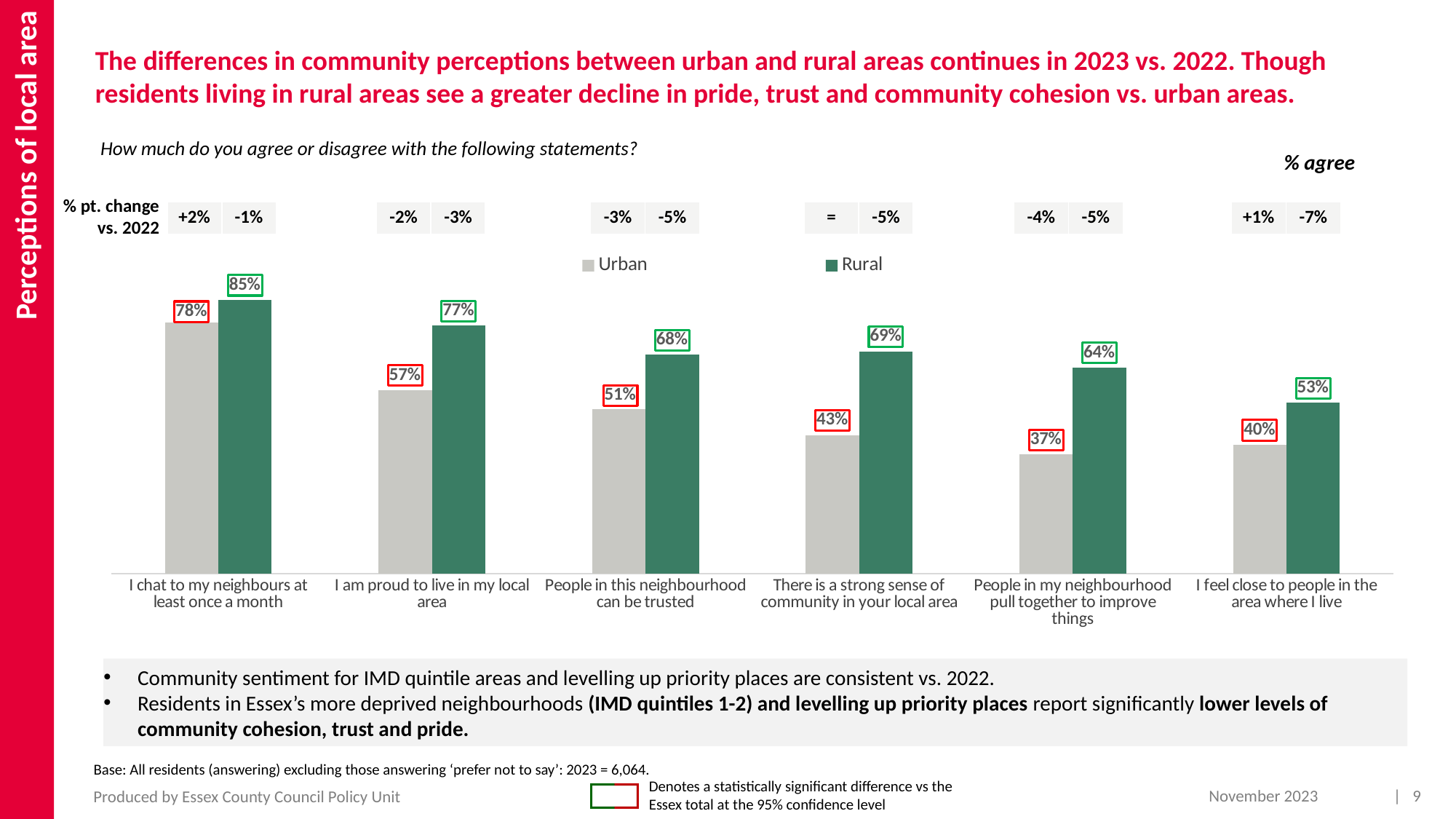
Which statement has the lowest Urban agreement? People in my neighbourhood pull together to improve things Which colour represents the Rural series in the chart? Green What is the percentage point change vs. 2022 for Rural residents on 'I feel close to people in the area where I live'? -7% What percentage of Rural residents agree with 'People in this neighbourhood can be trusted'? 68% Which statement has the highest Rural agreement? I chat to my neighbours at least once a month How many series does the chart legend list? 2 What is the difference between the Rural and Urban values for 'There is a strong sense of community in your local area'? 26% What kind of chart is shown on the slide? Bar chart What is the Urban value for 'People in my neighbourhood pull together to improve things'? 37% How many statements are shown on the x axis of the chart? 6 Which is larger for 'I feel close to people in the area where I live', the Urban or the Rural value? Rural What percentage of Urban residents agree with 'I chat to my neighbours at least once a month'? 78%